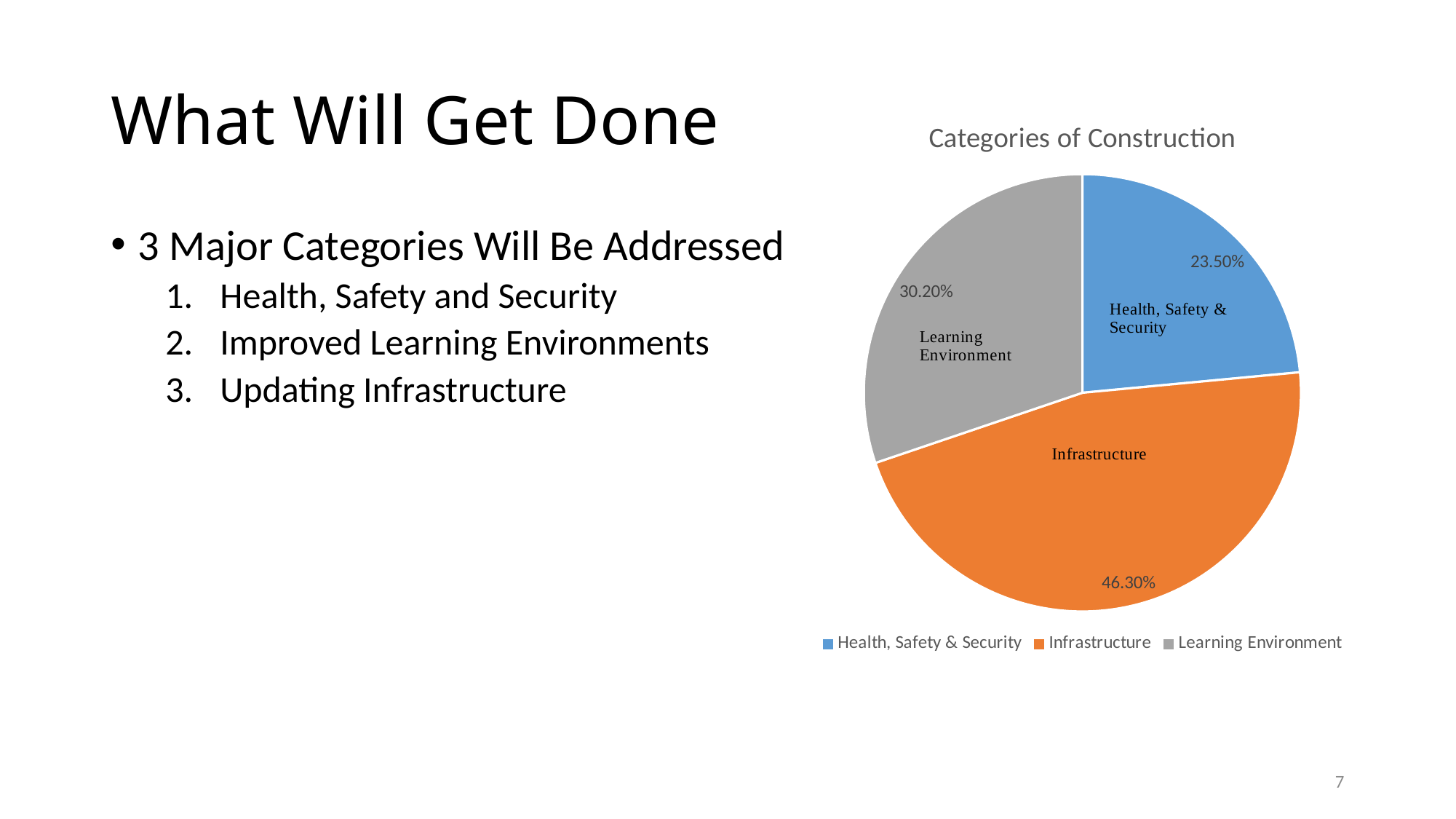
Which category has the largest share of the pie? Infrastructure How many slices does the pie chart have? 3 What percentage of the pie does Learning Environment account for? 30.20% Which is larger, the share for Learning Environment or the share for Health, Safety & Security? Learning Environment Which category has the smallest share of the pie? Health, Safety & Security What percentage of the pie does Infrastructure account for? 46.30% Which colour represents Infrastructure in the pie chart? Orange What is the difference in percentage points between Infrastructure and Learning Environment? 16.10% What is the title of the chart? Categories of Construction What kind of chart is shown on the slide? Pie chart What is the difference in percentage points between Learning Environment and Health, Safety & Security? 6.70% What percentage of the pie does Health, Safety & Security account for? 23.50%